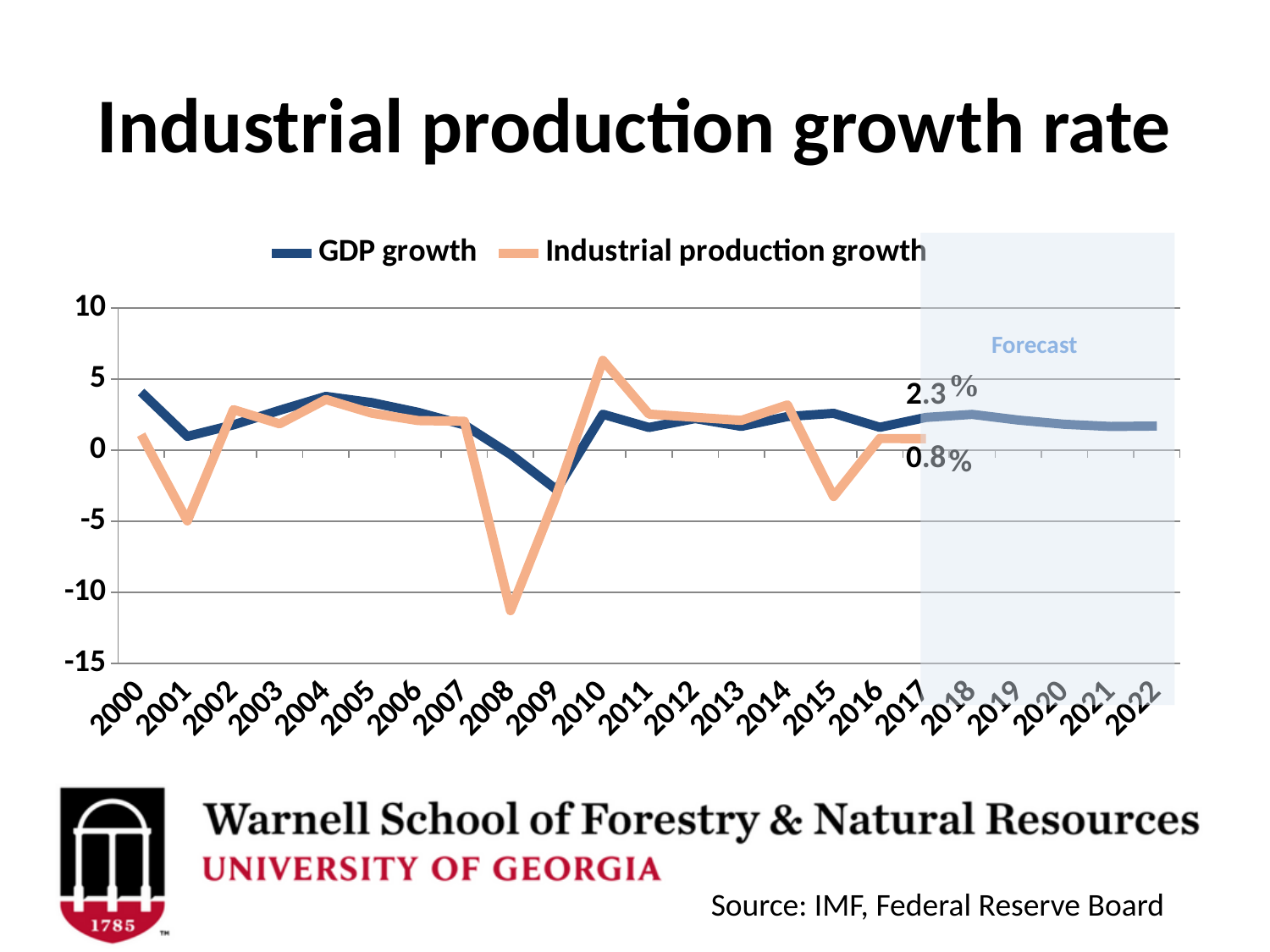
Is the Industrial production growth value for 2009 greater or less than -10? greater What is the difference between GDP growth (2.3%) and Industrial production growth (0.8%) in 2017? 1.5% What is the GDP growth value labelled for 2017? 2.3% In 2017, which is larger: GDP growth or Industrial production growth? GDP growth How many series does the legend list? 2 In which year is Industrial production growth at its highest? 2010 Is the Industrial production growth value for 2010 greater or less than 5? greater In which year is Industrial production growth at its lowest? 2008 What are the two series named in the legend? GDP growth and Industrial production growth What kind of chart is shown on the slide? Line chart What is the Industrial production growth value labelled for 2017? 0.8% How many years are shown on the x axis? 23